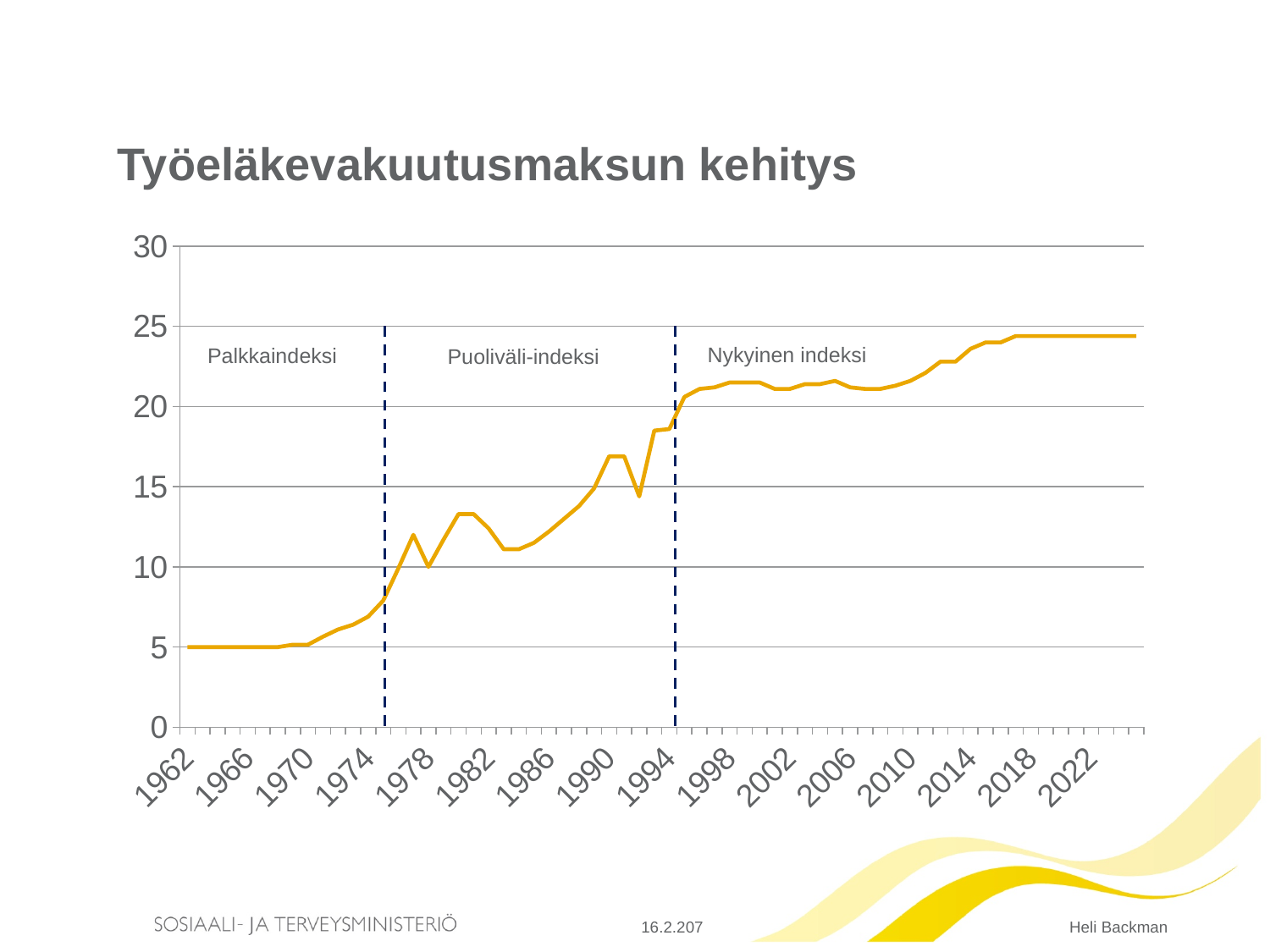
Is the value for 1990 greater or less than 10? greater Is the value for 1970 greater or less than 10? less Is the value for 2022 greater or less than 20? greater What is the title of the chart? Työeläkevakuutusmaksun kehitys Overall, do the values rise or fall from 1962 to 2022? rise What kind of chart is shown on the slide? line chart What are the three period labels written on the chart, from left to right? Palkkaindeksi, Puoliväli-indeksi, Nykyinen indeksi Which year has the larger value, 1962 or 2022? 2022 Which year has the larger value, 1980 or 1990? 1990